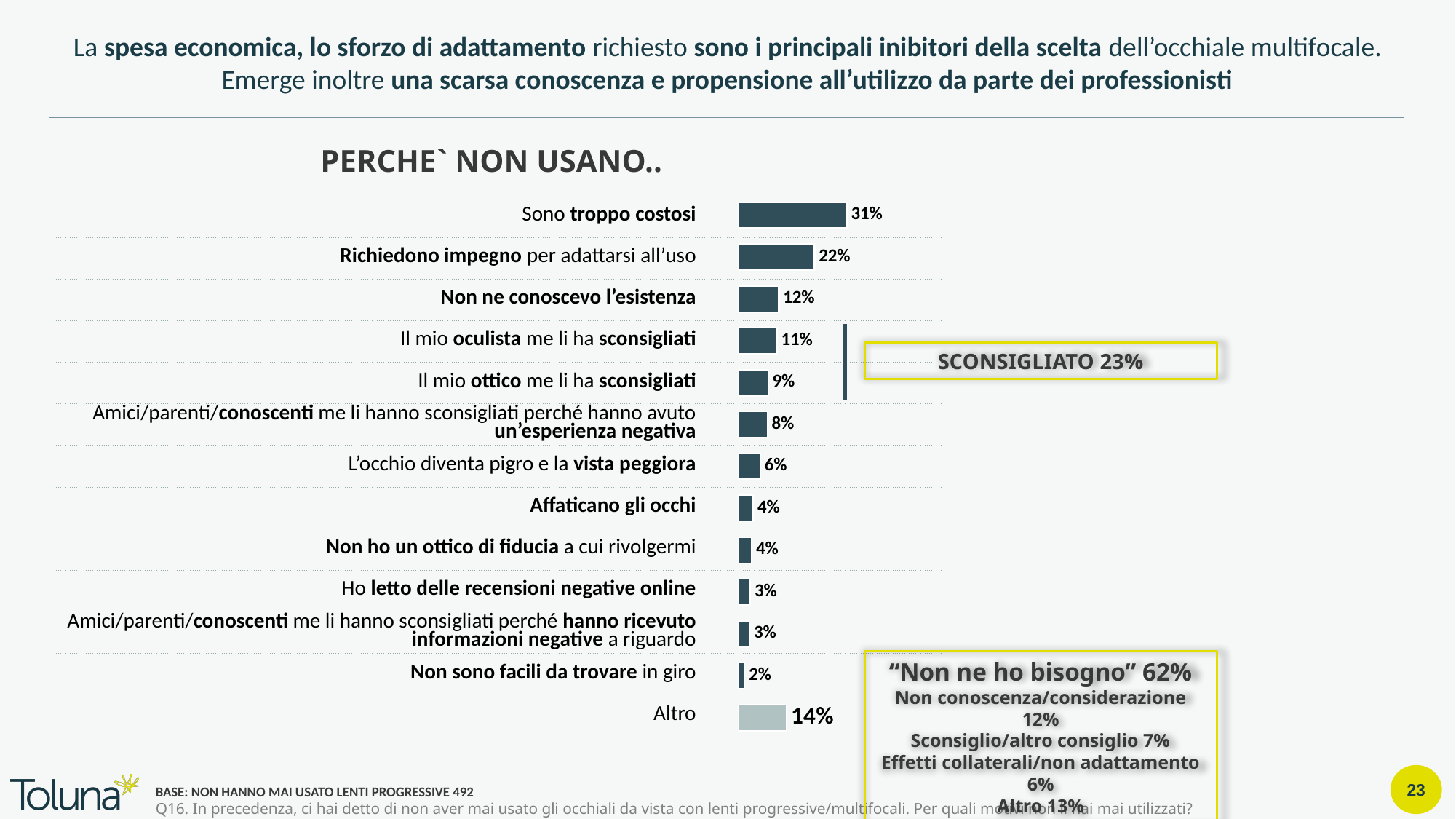
What percentage is shown in the box labelled "SCONSIGLIATO" next to the chart? 23% Which category has the highest value in the chart? Sono troppo costosi Which is larger: the value for "Il mio oculista me li ha sconsigliati" or the value for "L'occhio diventa pigro e la vista peggiora"? Il mio oculista me li ha sconsigliati What is the value for "Il mio ottico me li ha sconsigliati"? 9% How many categories are shown in the bar chart? 13 What is the value for "Richiedono impegno per adattarsi all'uso"? 22% What is the value for "Altro"? 14% What kind of chart is shown under the title "PERCHE` NON USANO.."? bar chart Which category has the lowest value in the chart? Non sono facili da trovare in giro What is the value for "Non ne conoscevo l'esistenza"? 12% What is the value for "Sono troppo costosi"? 31% What is the difference between the values for "Sono troppo costosi" and "Richiedono impegno per adattarsi all'uso"? 9%